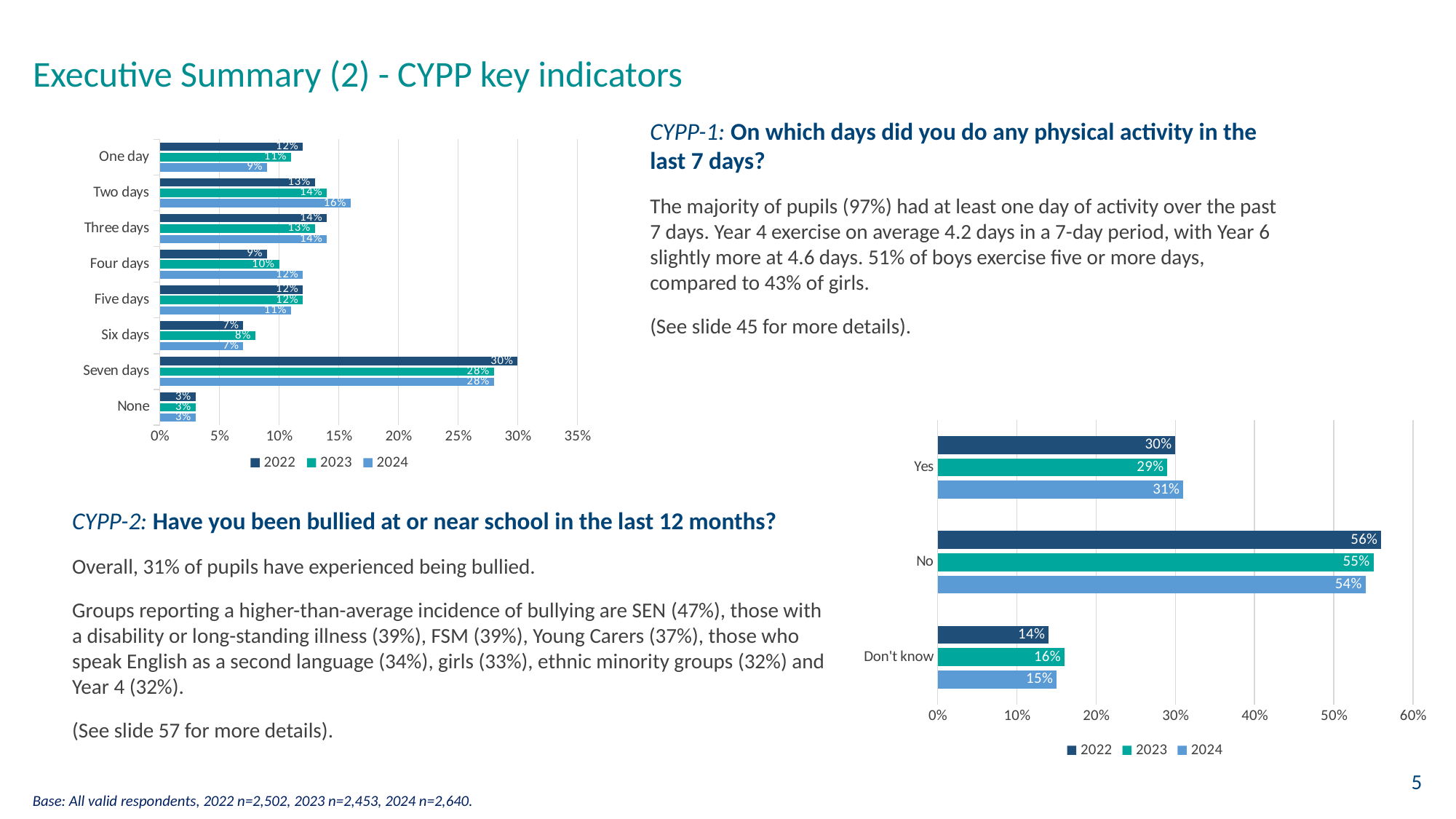
In the bottom-right chart, which series is shown in the darkest blue colour? 2022 In the bottom-right chart, what is the difference between the 'No' and 'Yes' values for 2024? 23% In the top-left chart, which is larger for 2023: 'Four days' or 'Six days'? Four days In the top-left chart, what is the value for 'Seven days' in 2022? 30% How many series does the legend of the top-left chart list? 3 In the bottom-right chart, what is the value for 'Don't know' in 2023? 16% In the top-left chart, what is the value for 'Two days' in 2024? 16% In the bottom-right chart, what is the value for 'No' in 2022? 56% What type of chart is the bottom-right chart? Bar chart How many categories are shown in the bottom-right chart? 3 In the top-left chart, which category has the highest value for 2024? Seven days In the top-left chart, which category has the lowest value for 2022? None